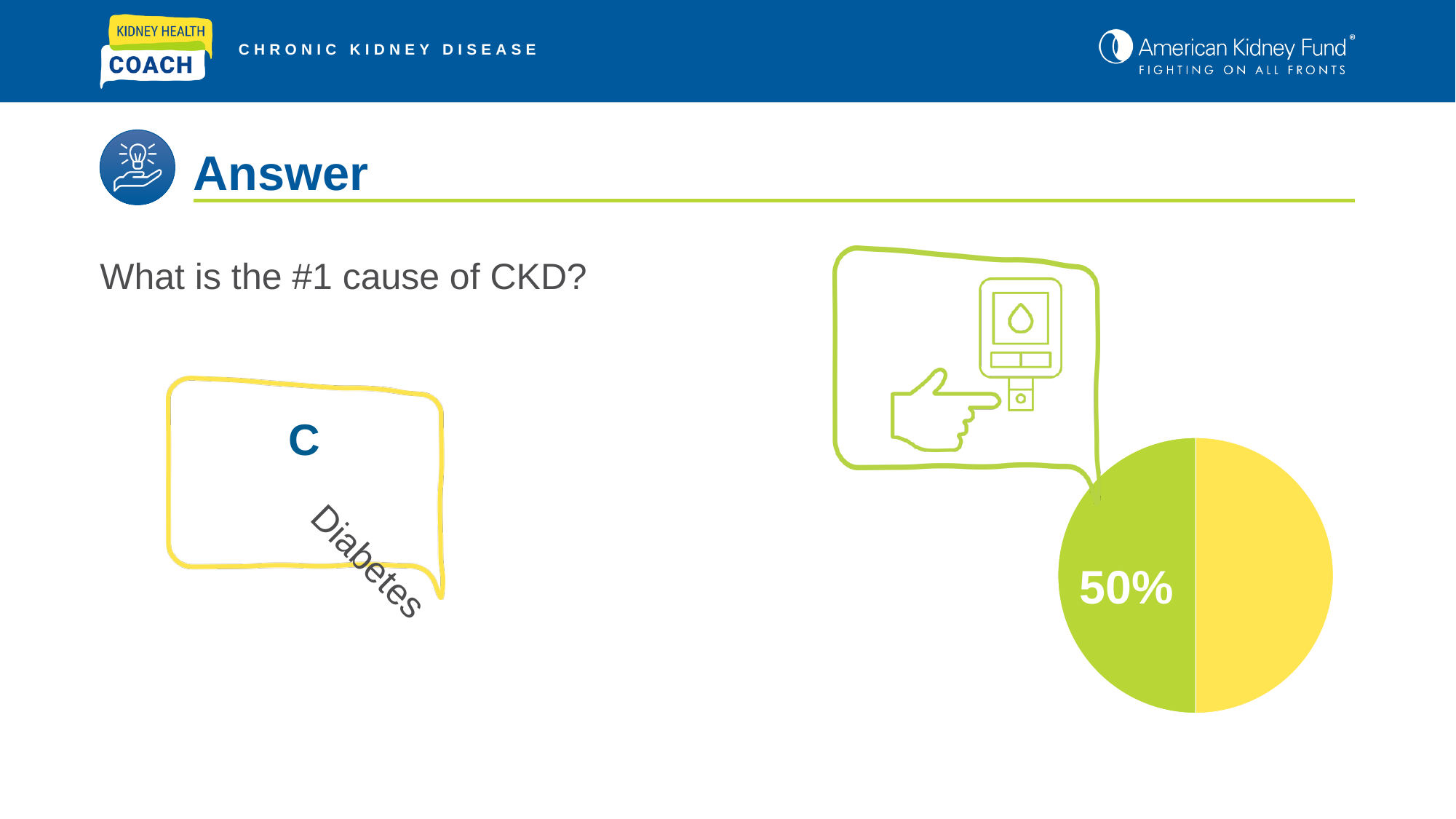
Is the green slice of the pie chart larger or smaller than the yellow slice? the same size Does the pie chart have a legend? No What percentage is printed on the green slice of the pie chart? 50% How many slices does the pie chart have? 2 What two colours are used for the slices of the pie chart? green and yellow What share of the pie does the green slice represent? 50% What kind of chart is shown on the slide? pie chart